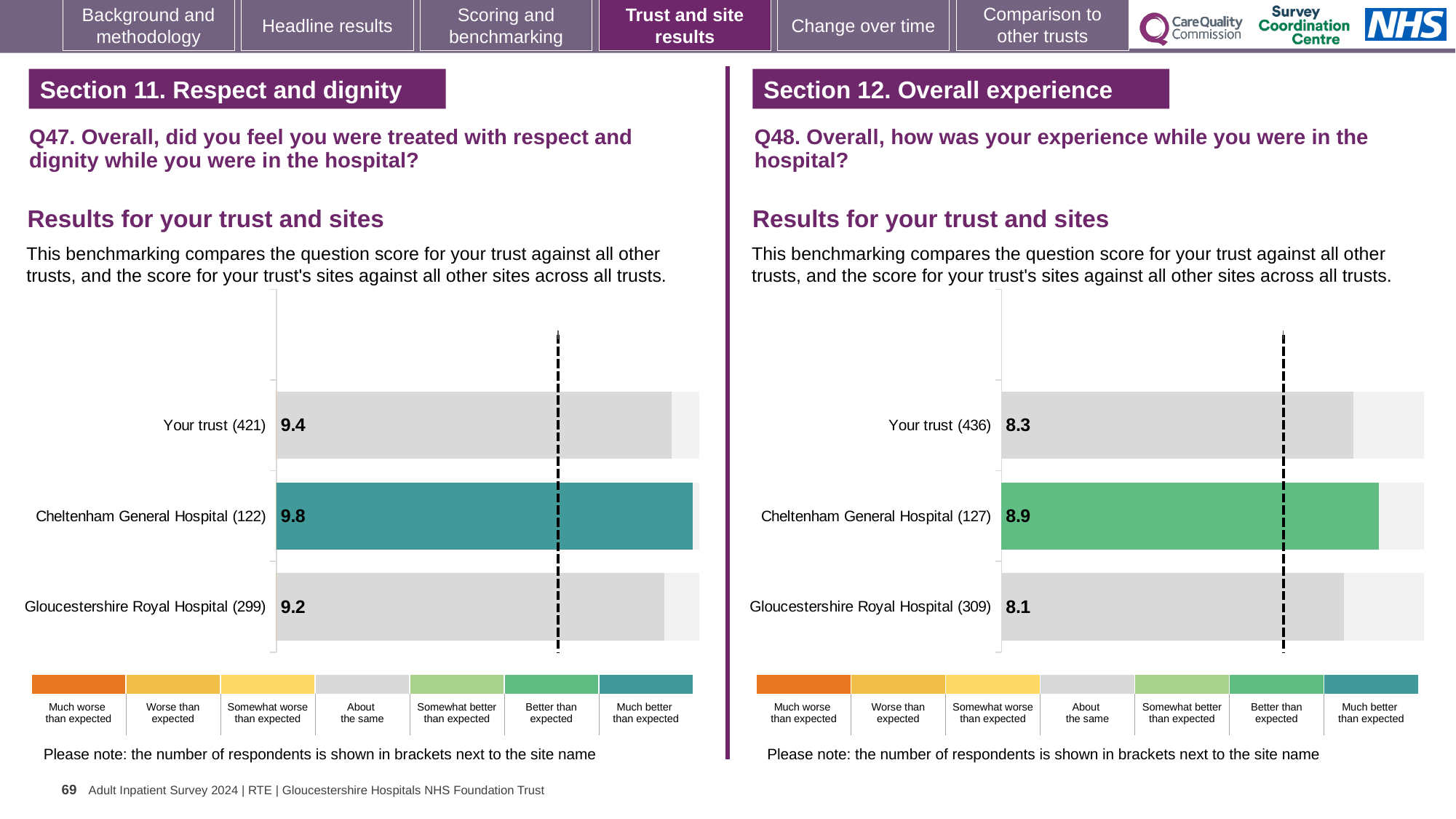
On the Q47 chart (left), what is the score for Cheltenham General Hospital? 9.8 What kind of chart is used on the Q47 chart (left)? Bar chart On the Q48 chart (right), how many bars are plotted? 3 On the Q47 chart (left), what is the score for Your trust? 9.4 On the Q48 chart (right), which site or trust has the highest score? Cheltenham General Hospital On the Q47 chart (left), how many respondents are shown for Your trust? 421 On the Q48 chart (right), what is the difference between the scores for Cheltenham General Hospital and Your trust? 0.6 On the Q47 chart (left), what is the difference between the scores for Cheltenham General Hospital and Gloucestershire Royal Hospital? 0.6 On the Q48 chart (right), what is the score for Gloucestershire Royal Hospital? 8.1 On the Q48 chart (right), which benchmark category does the colour of the Cheltenham General Hospital bar correspond to? Better than expected On the Q48 chart (right), which has the larger score: Your trust or Gloucestershire Royal Hospital? Your trust On the Q47 chart (left), which site or trust has the lowest score? Gloucestershire Royal Hospital